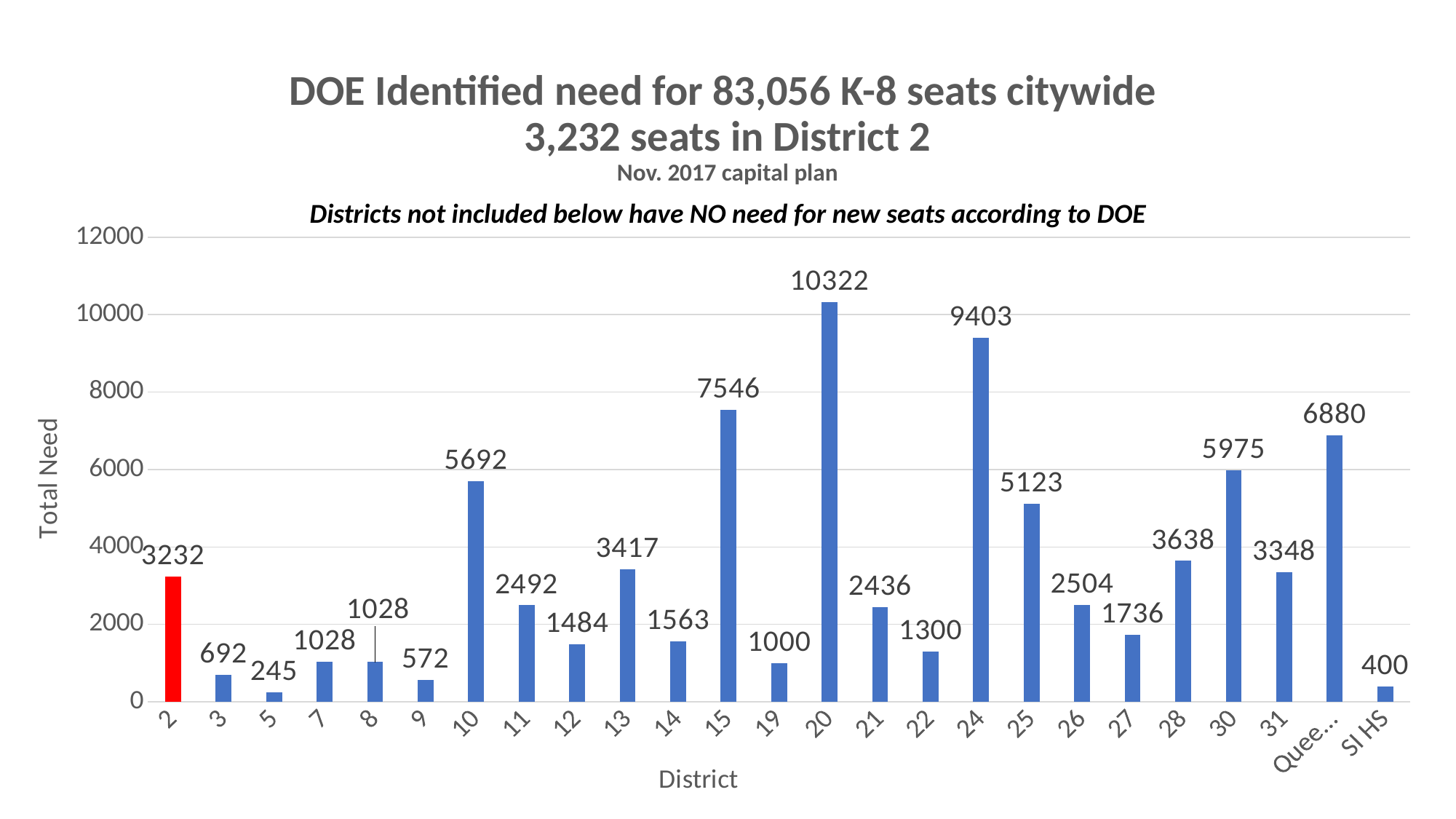
Which district's bar is coloured red? District 2 Which has a larger total need, District 28 or District 31? District 28 What is the total need value for District 20? 10322 Which district has the lowest total need? 5 What is the difference in total need between District 15 and District 10? 1854 How many districts (bars) are shown on the chart? 25 Which district has the highest total need? 20 What is the difference in total need between District 20 and District 24? 919 Is the value for District 15 greater or less than 6000? greater What is the total need value for District 2? 3232 What is the total need value for SI HS? 400 What kind of chart is shown on the slide? Bar chart